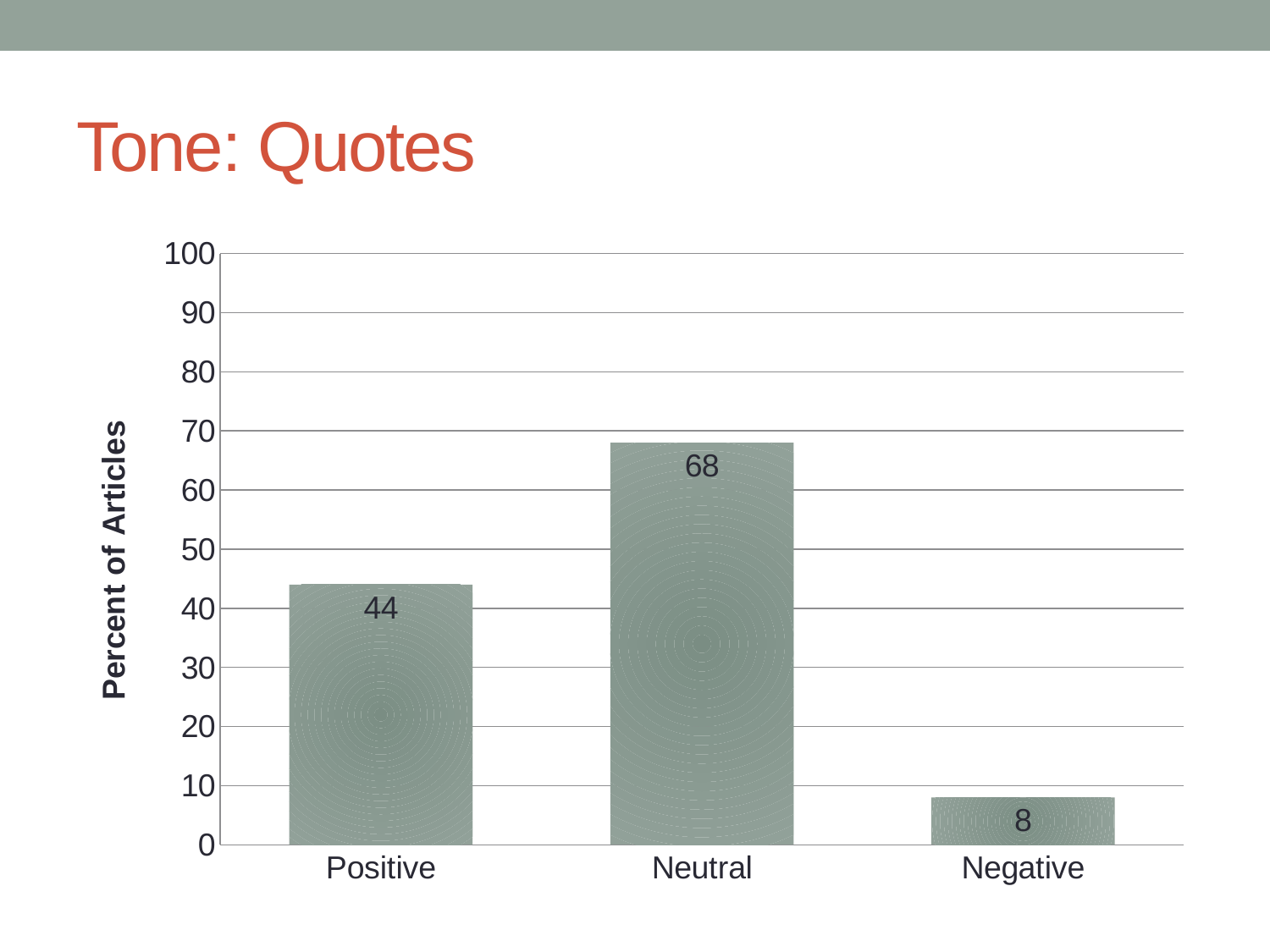
What is the difference between the values for Positive and Negative? 36 What is the value for Neutral? 68 How many categories are shown on the x axis? 3 What is the label of the vertical axis? Percent of Articles Which category has the lowest value? Negative Which is larger, the value for Positive or the value for Negative? Positive What is the difference between the values for Neutral and Positive? 24 What kind of chart is shown on the slide? bar chart What is the value for Positive? 44 What is the value for Negative? 8 Is the value for Neutral greater or less than 60? greater Which category has the highest value? Neutral